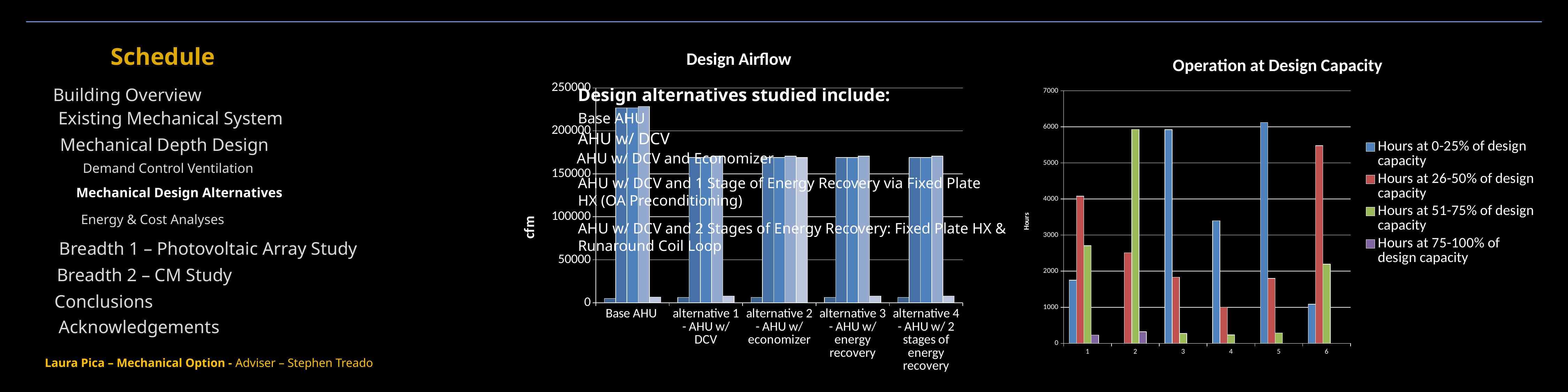
In the Operation at Design Capacity chart, which category has the highest value for Hours at 51-75% of design capacity? 2 In the Design Airflow chart, is the tallest bar for alternative 2 - AHU w/ economizer greater or less than 200000? less In the Operation at Design Capacity chart, for category 1, which is larger: Hours at 0-25% of design capacity or Hours at 26-50% of design capacity? Hours at 26-50% of design capacity In the Operation at Design Capacity chart, which category has the highest value for Hours at 26-50% of design capacity? 6 In the Design Airflow chart, is the tallest bar for Base AHU greater or less than 200000? greater How many series does the legend of the Operation at Design Capacity chart list? 4 In the Design Airflow chart, which has the taller tallest bar: Base AHU or alternative 3 - AHU w/ energy recovery? Base AHU In the Operation at Design Capacity chart, is the value of Hours at 0-25% of design capacity for category 5 greater or less than 5000? greater What is the y-axis label of the Design Airflow chart? cfm How many categories are shown on the x axis of the Operation at Design Capacity chart? 6 How many categories are shown on the x axis of the Design Airflow chart? 5 What kind of chart is the Design Airflow chart? bar chart